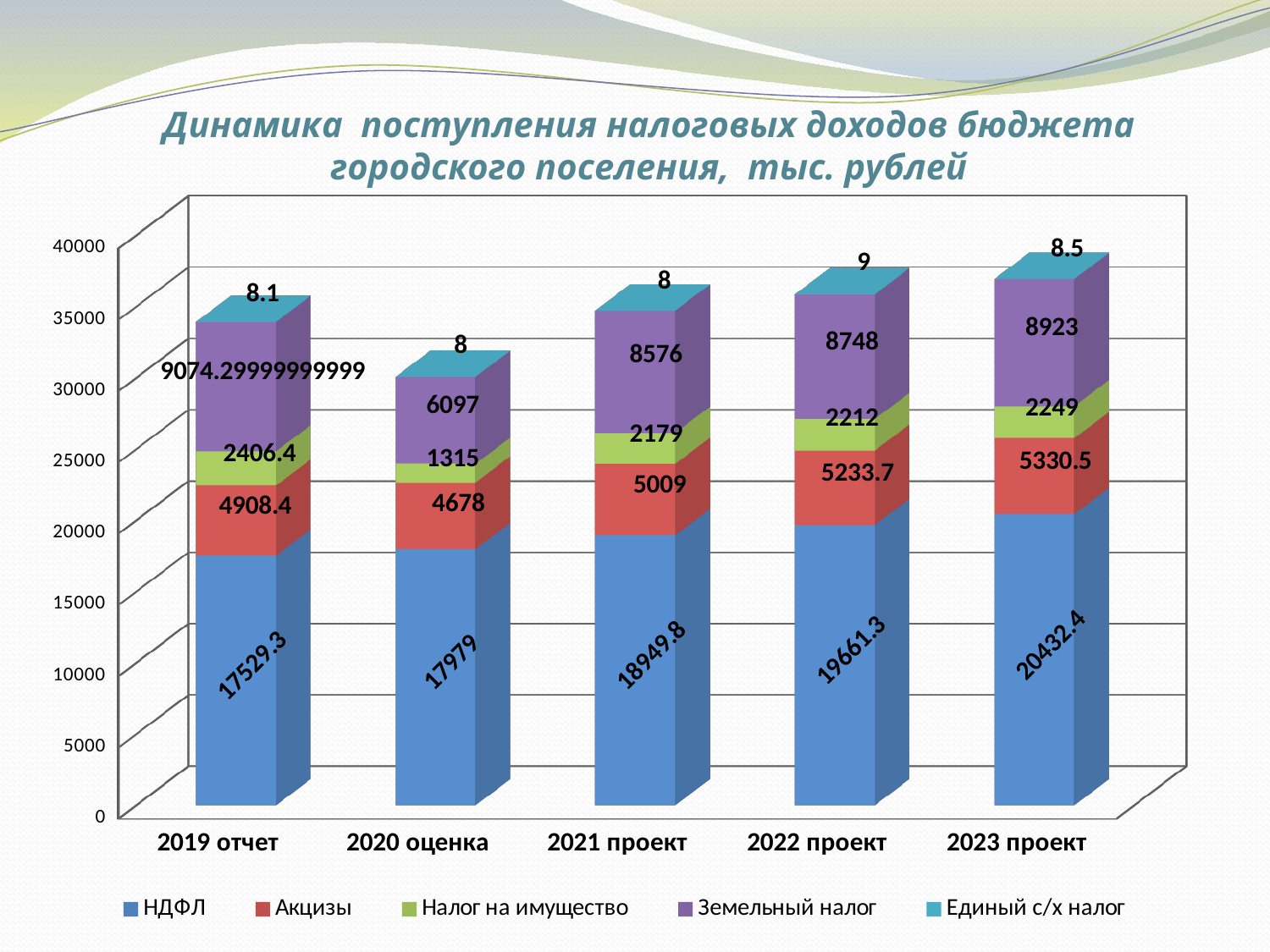
Does НДФЛ rise or fall from 2019 отчет to 2023 проект? Rises How many categories are shown on the x axis? 5 In which category is Земельный налог lowest? 2020 оценка What is the value of Акцизы for 2023 проект? 5330.5 In which category is НДФЛ highest? 2023 проект What is the value of Единый с/х налог for 2022 проект? 9 What is the value of Земельный налог for 2020 оценка? 6097 What kind of chart is shown? Stacked bar chart What is the difference between Земельный налог for 2023 проект and 2022 проект? 175 Which is larger: Налог на имущество for 2019 отчет or for 2021 проект? 2019 отчет How many series does the legend list? 5 What is the value of НДФЛ for 2021 проект? 18949.8